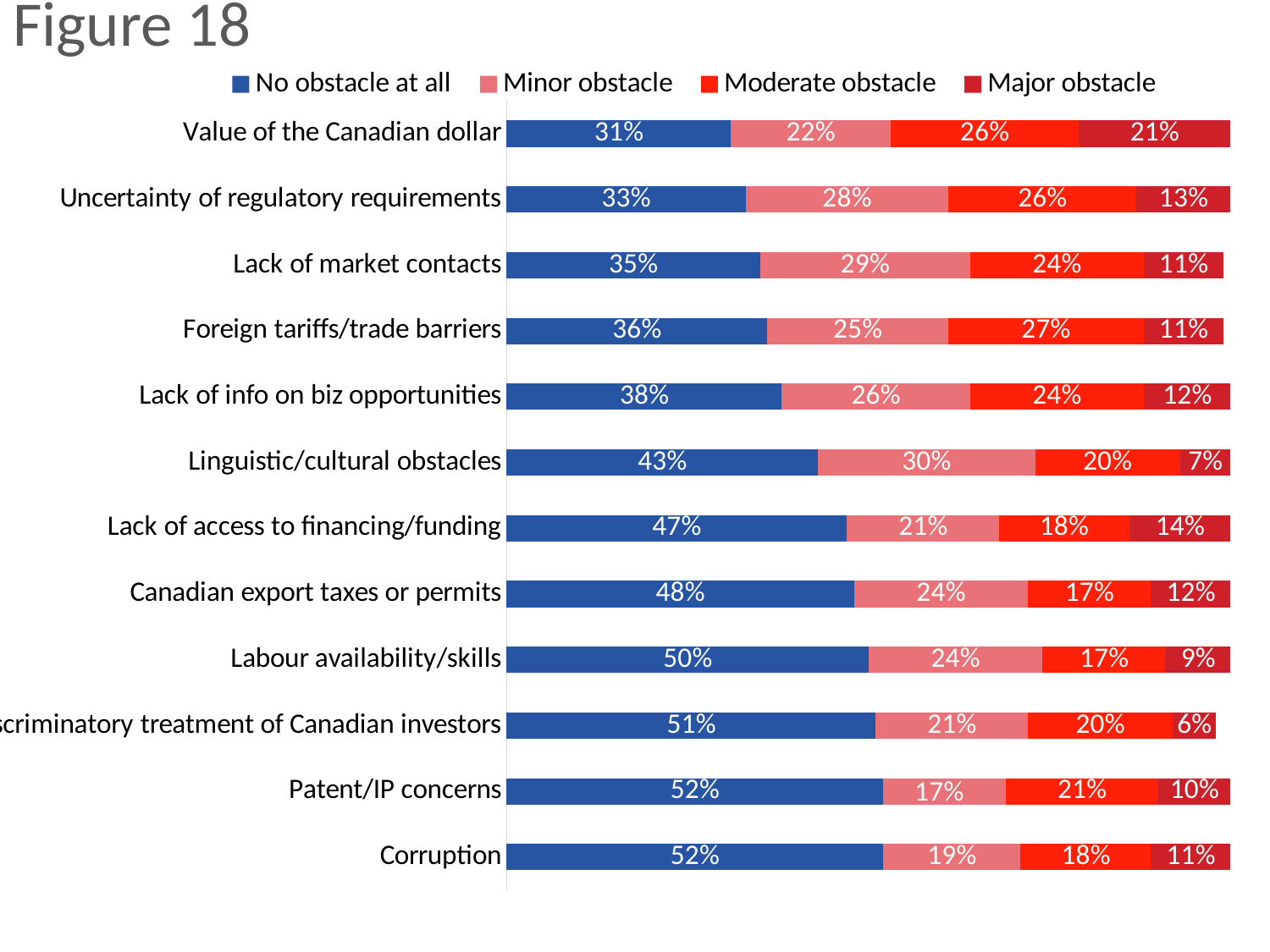
What is the 'Minor obstacle' value for Lack of market contacts? 29% Which category has the lowest 'No obstacle at all' value? Value of the Canadian dollar Which is larger: the 'Moderate obstacle' value for Foreign tariffs/trade barriers or for Labour availability/skills? Foreign tariffs/trade barriers What is the 'No obstacle at all' value for Corruption? 52% Which category has the highest 'Major obstacle' value? Value of the Canadian dollar How many series does the legend list? 4 What is the 'Major obstacle' value for Value of the Canadian dollar? 21% How many categories are plotted on the chart? 12 What is the difference between the 'No obstacle at all' and 'Major obstacle' values for Linguistic/cultural obstacles? 36 percentage points What kind of chart is shown on the slide? Stacked bar chart Which category has the highest 'Minor obstacle' value? Linguistic/cultural obstacles What is the 'Moderate obstacle' value for Lack of access to financing/funding? 18%